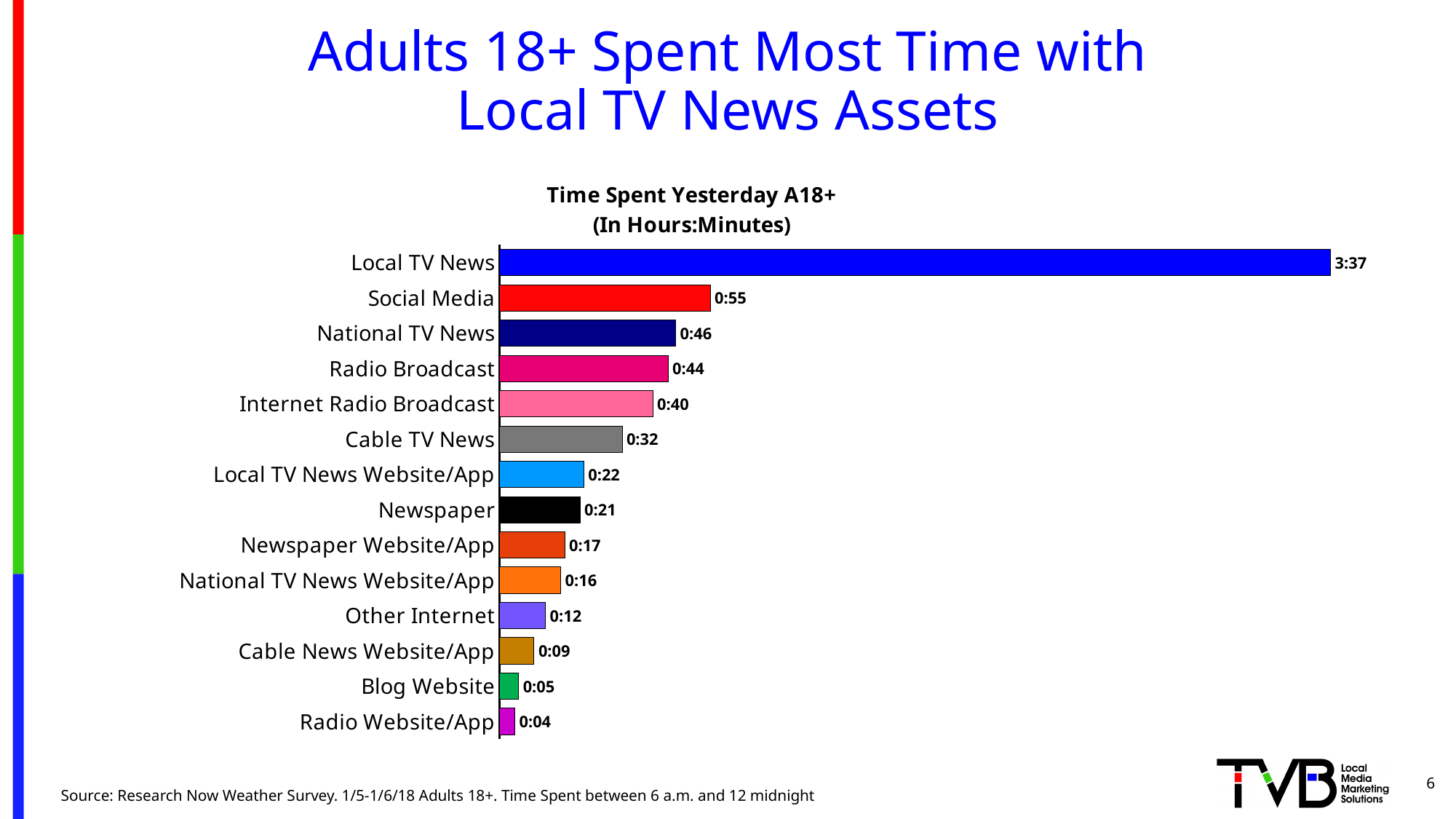
Which category has the lowest time spent? Radio Website/App What is the time spent yesterday for Local TV News? 3:37 What is the time spent yesterday for Cable TV News? 0:32 What is the time spent yesterday for Newspaper Website/App? 0:17 What is the title of the chart? Time Spent Yesterday A18+ (In Hours:Minutes) Which category has the highest time spent? Local TV News Which has a higher time spent, Radio Broadcast or Internet Radio Broadcast? Radio Broadcast Which has a higher time spent, Blog Website or Other Internet? Other Internet What is the time spent yesterday for Social Media? 0:55 How many categories are shown in the chart? 14 What is the difference in minutes between Social Media and National TV News? 9 minutes What kind of chart is shown on the slide? Bar chart